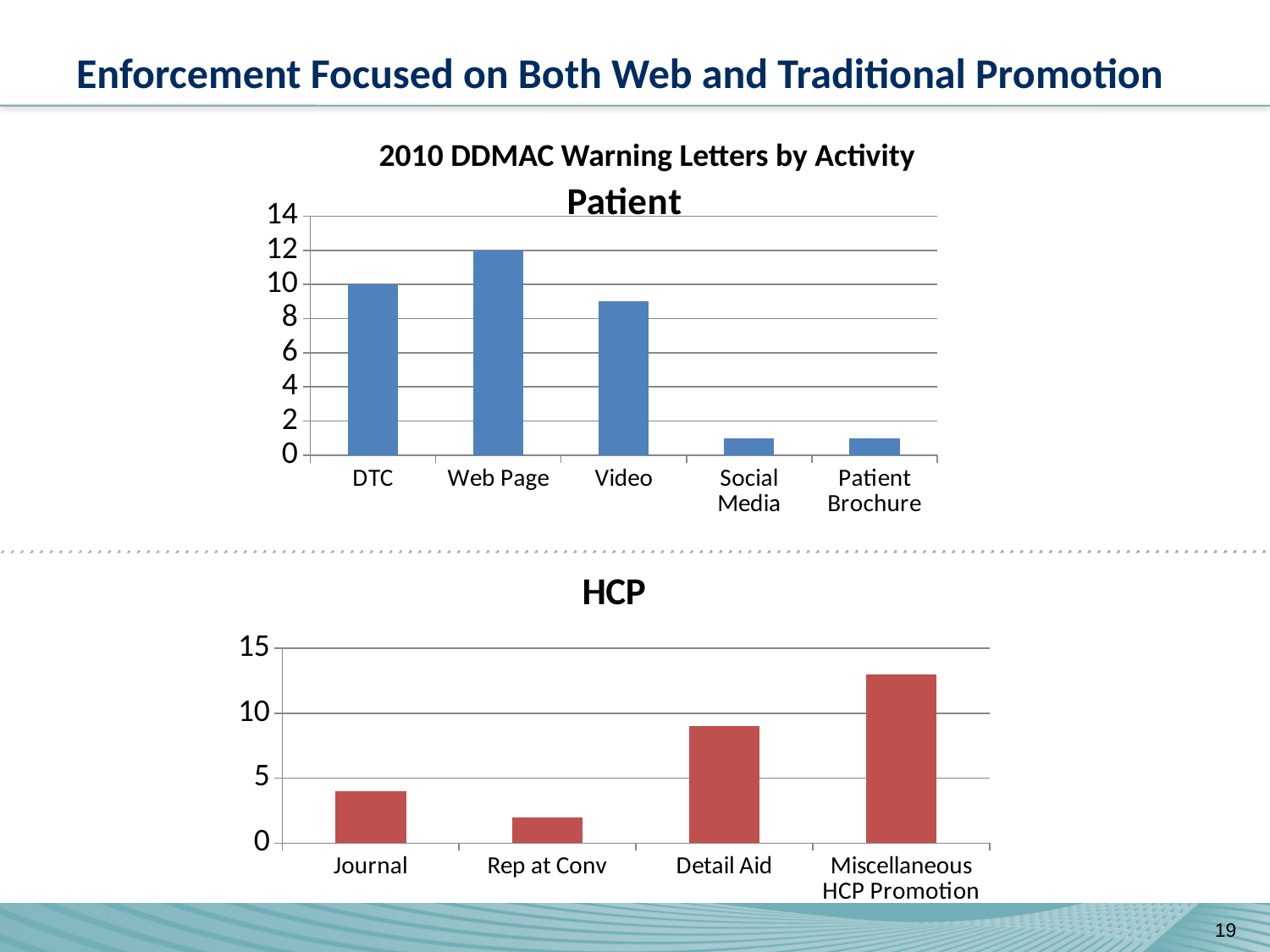
How many categories are shown in the HCP chart? 4 What kind of chart is the Patient chart? bar chart In the HCP chart, which category has the lowest value? Rep at Conv In the Patient chart, what is the difference between the Web Page and DTC values? 2 In the HCP chart, which category has the highest value? Miscellaneous HCP Promotion How many categories are shown in the Patient chart? 5 In the HCP chart, is the value for Detail Aid greater or less than 5? greater In the Patient chart, which category has the highest value? Web Page In the Patient chart, what is the value for DTC? 10 In the Patient chart, is the value for Video greater or less than 8? greater In the HCP chart, which is larger, Journal or Detail Aid? Detail Aid In the Patient chart, what is the value for Web Page? 12